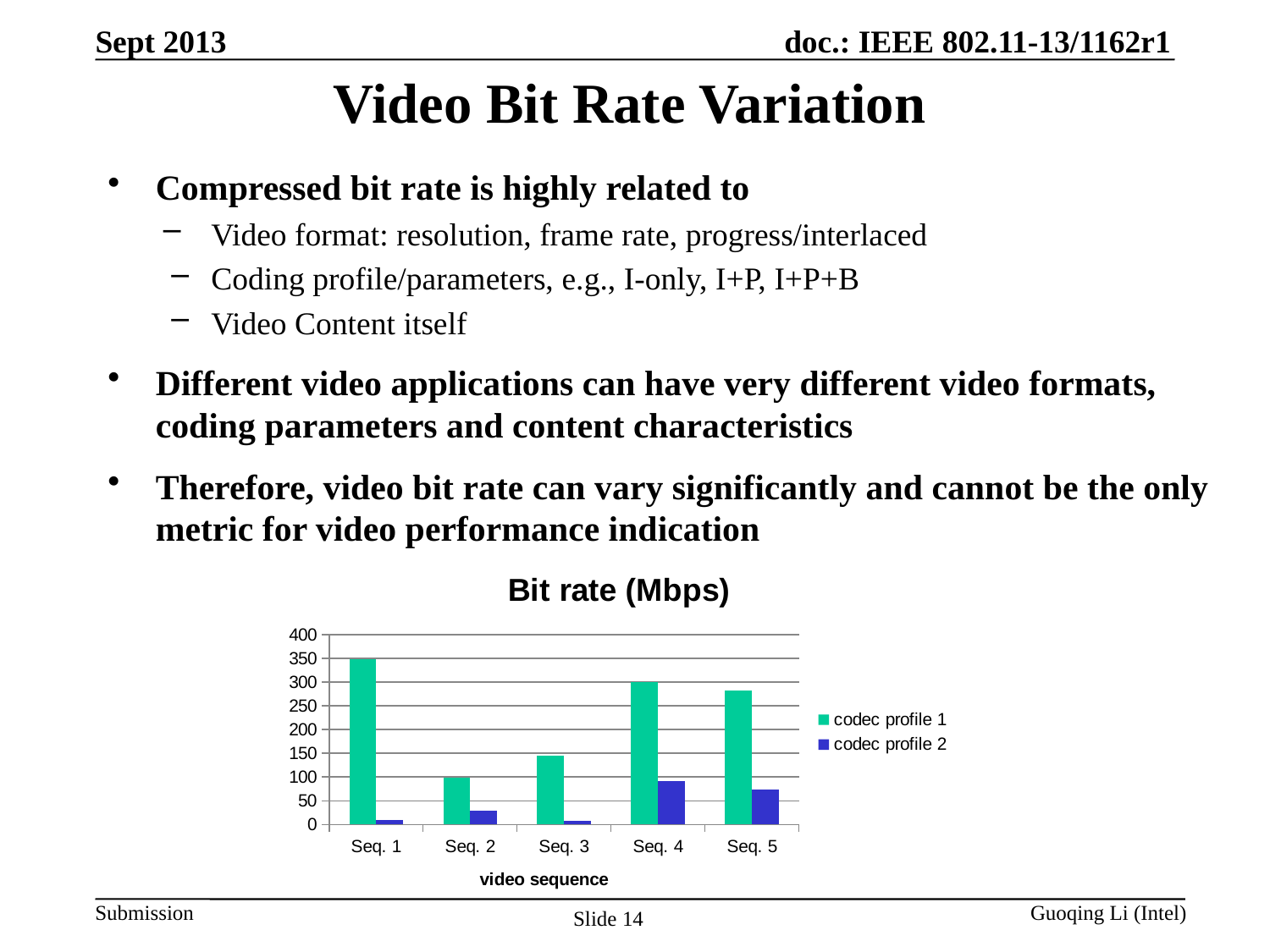
Which video sequence has the lowest bit rate for codec profile 1? Seq. 2 Is the codec profile 1 bit rate for Seq. 1 greater or less than 300? greater Is the codec profile 1 bit rate for Seq. 3 greater or less than 200? less How many series does the chart legend list? 2 What is the x-axis label of the chart? video sequence What type of chart is shown on the slide? bar chart What is the title of the chart? Bit rate (Mbps) How many video sequences are shown on the x axis of the chart? 5 Which video sequence has the highest bit rate for codec profile 1? Seq. 1 For Seq. 1, which series has the larger bit rate, codec profile 1 or codec profile 2? codec profile 1 Which video sequence has the highest bit rate for codec profile 2? Seq. 4